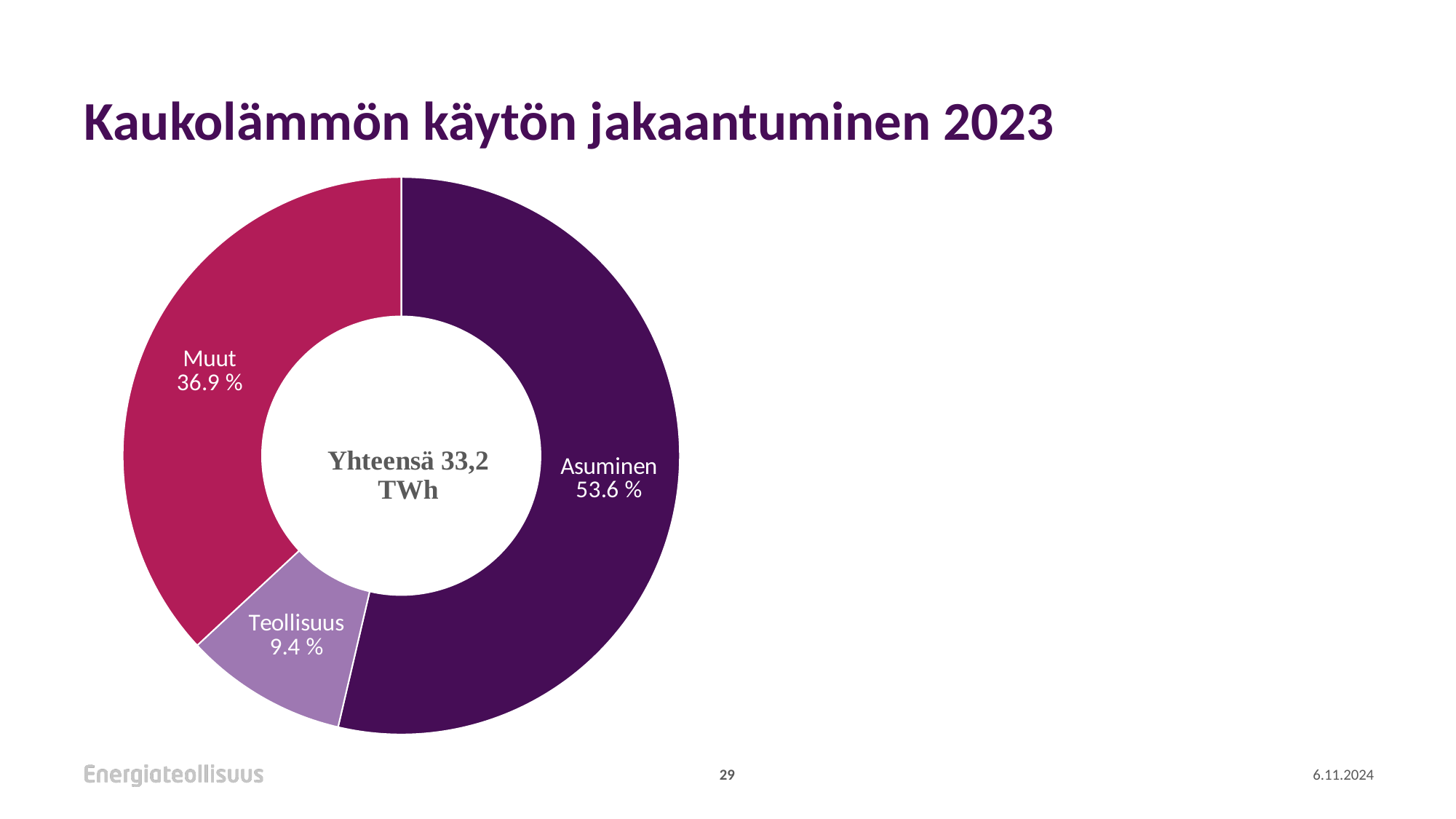
What share of district heating use does Asuminen account for? 53.6 % What is the difference in percentage points between the Muut and Teollisuus shares? 27.5 What total is printed in the centre of the chart? Yhteensä 33,2 TWh What kind of chart is shown on the slide? Pie chart (doughnut) How many categories are shown in the chart? 3 Which is larger, the share for Muut or the share for Teollisuus? Muut Which category has the smallest share of the chart? Teollisuus Which category has the largest share of the chart? Asuminen What share of district heating use does Teollisuus account for? 9.4 % What is the title of the slide? Kaukolämmön käytön jakaantuminen 2023 What share of district heating use does Muut account for? 36.9 % What is the difference in percentage points between the Asuminen and Muut shares? 16.7